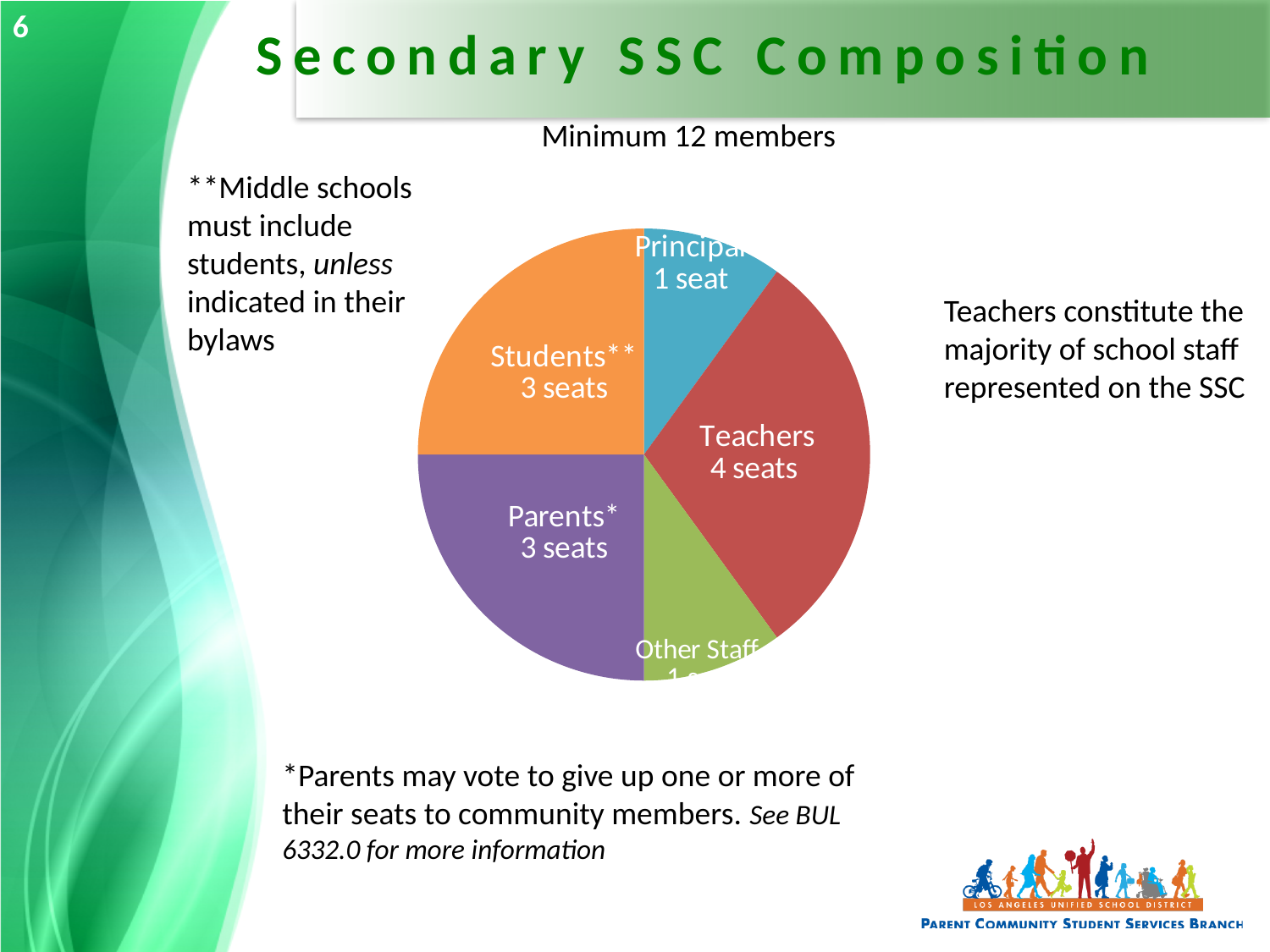
How many slices does the pie chart have? 5 Which group has the largest slice of the pie chart? Teachers How many more seats do Teachers have than the Principal? 3 seats Which group has more seats, Teachers or Students? Teachers Which group has more seats, the Principal or Parents? Parents How many seats do Teachers have on the Secondary SSC according to the pie chart? 4 seats What kind of chart is shown on the slide? pie chart What is the title of the slide containing the pie chart? Secondary SSC Composition How many seats does the Principal have according to the pie chart? 1 seat How many seats do Students have according to the pie chart? 3 seats How many more seats do Teachers have than Parents? 1 seat How many seats do Parents have according to the pie chart? 3 seats